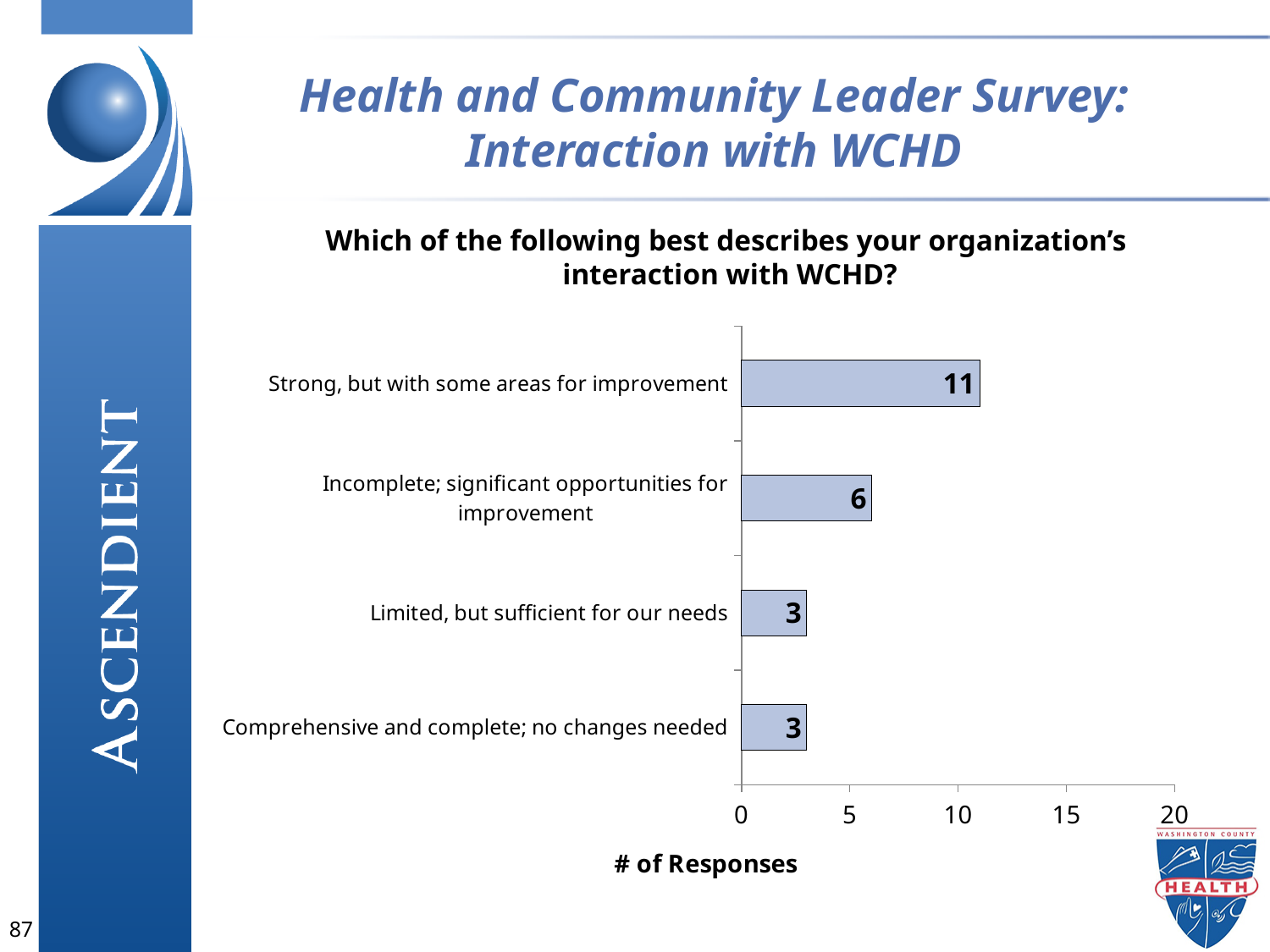
How many responses were for "Incomplete; significant opportunities for improvement"? 6 How many responses were for "Comprehensive and complete; no changes needed"? 3 Which category received the most responses? Strong, but with some areas for improvement What is the label of the horizontal axis? # of Responses What is the total number of responses across all four categories? 23 How many categories are shown in the chart? 4 What is the difference in responses between "Strong, but with some areas for improvement" and "Incomplete; significant opportunities for improvement"? 5 Which received more responses: "Incomplete; significant opportunities for improvement" or "Limited, but sufficient for our needs"? Incomplete; significant opportunities for improvement How many responses were for "Limited, but sufficient for our needs"? 3 Is the value for "Strong, but with some areas for improvement" greater or less than 10? greater How many responses were for "Strong, but with some areas for improvement"? 11 What type of chart is shown on the slide? Bar chart